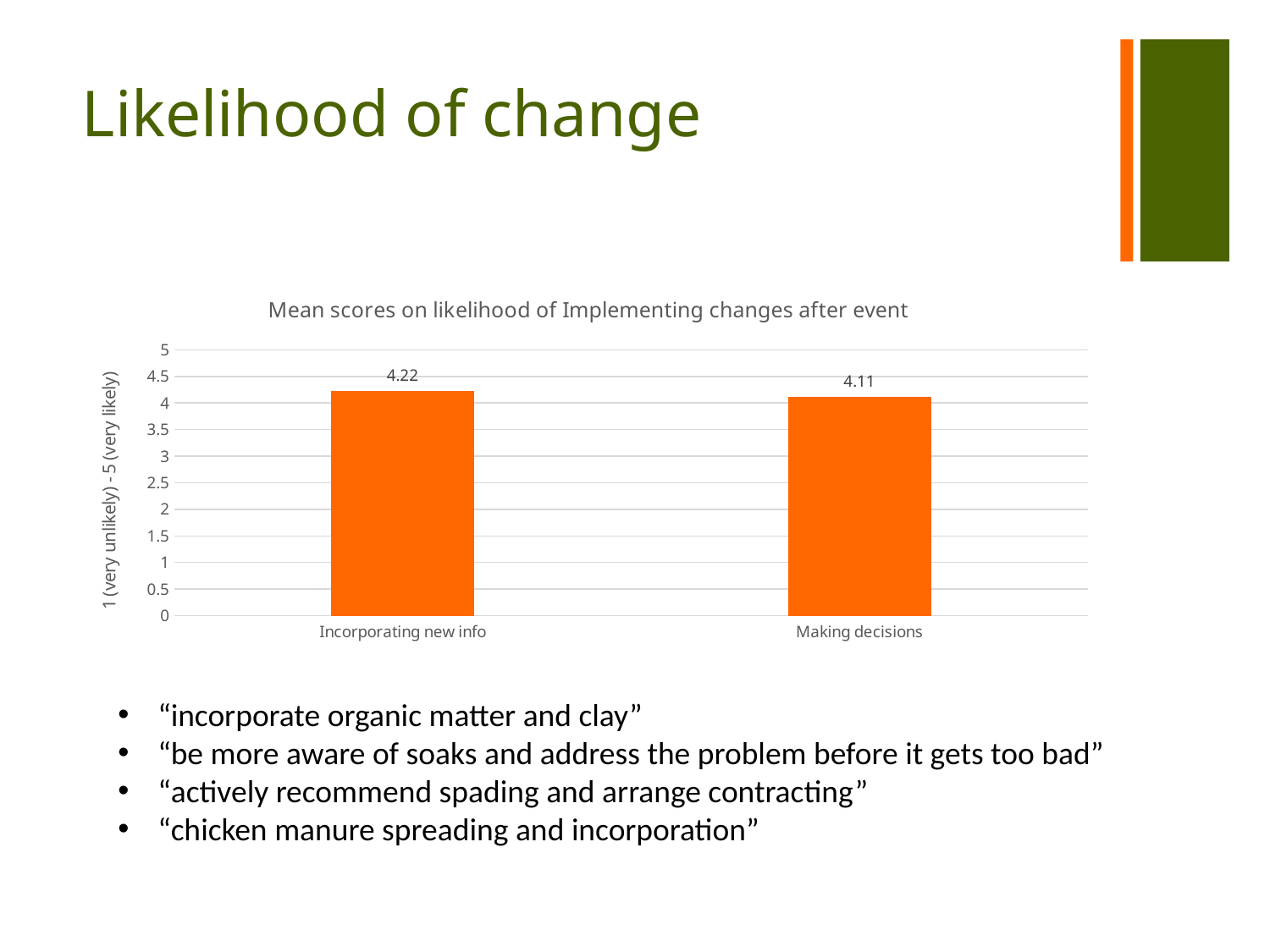
What is the difference between the mean scores for Incorporating new info and Making decisions? 0.11 How many categories are shown in the chart? 2 Which category has the higher mean score? Incorporating new info What is the mean score for Making decisions? 4.11 What is the label of the vertical axis? 1 (very unlikely) - 5 (very likely) Is the mean score for Making decisions greater or less than 4? greater What is the title of the chart? Mean scores on likelihood of Implementing changes after event What type of chart is shown on the slide? Bar chart Is the mean score for Incorporating new info greater or less than 4.5? less What is the maximum value shown on the vertical axis? 5 What is the mean score for Incorporating new info? 4.22 Which category has the lower mean score? Making decisions